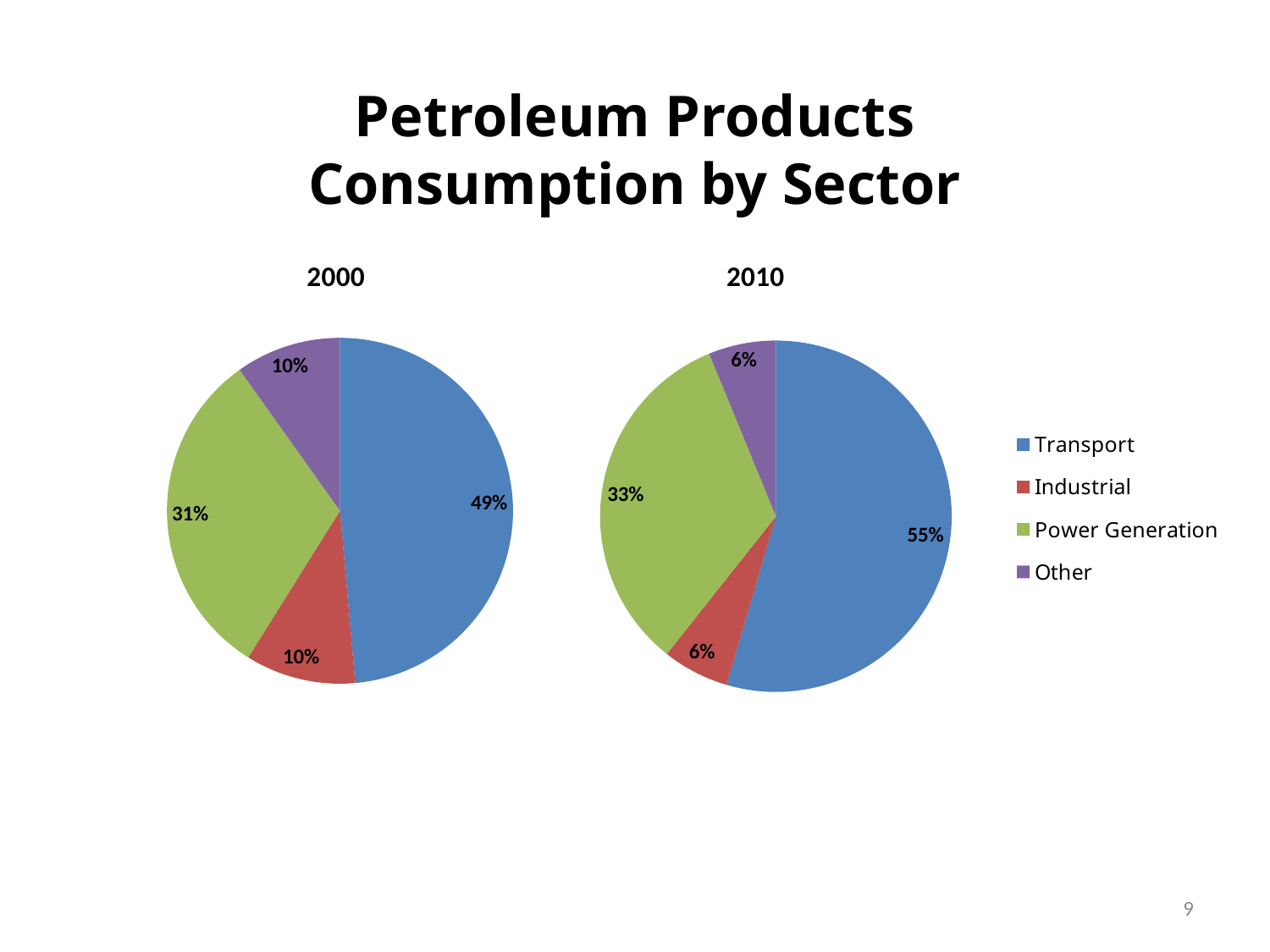
What colour represents Power Generation in the pie charts? green In the 2010 pie chart, which sector has the largest share? Transport In the 2000 pie chart, what share does Other have? 10% In the 2000 pie chart, what is the difference between the Transport share and the Power Generation share? 18% In the 2010 pie chart, what share does Power Generation have? 33% In the 2010 pie chart, what share does Industrial have? 6% Comparing the two pie charts, is the Transport share larger in 2000 or in 2010? 2010 What type of chart is used on this slide? pie chart In the 2000 pie chart, which sector has the largest share? Transport In the 2000 pie chart, what share does Transport have? 49% How many sectors does the legend list? 4 In the 2010 pie chart, is the Power Generation share larger or smaller than the Industrial share? larger